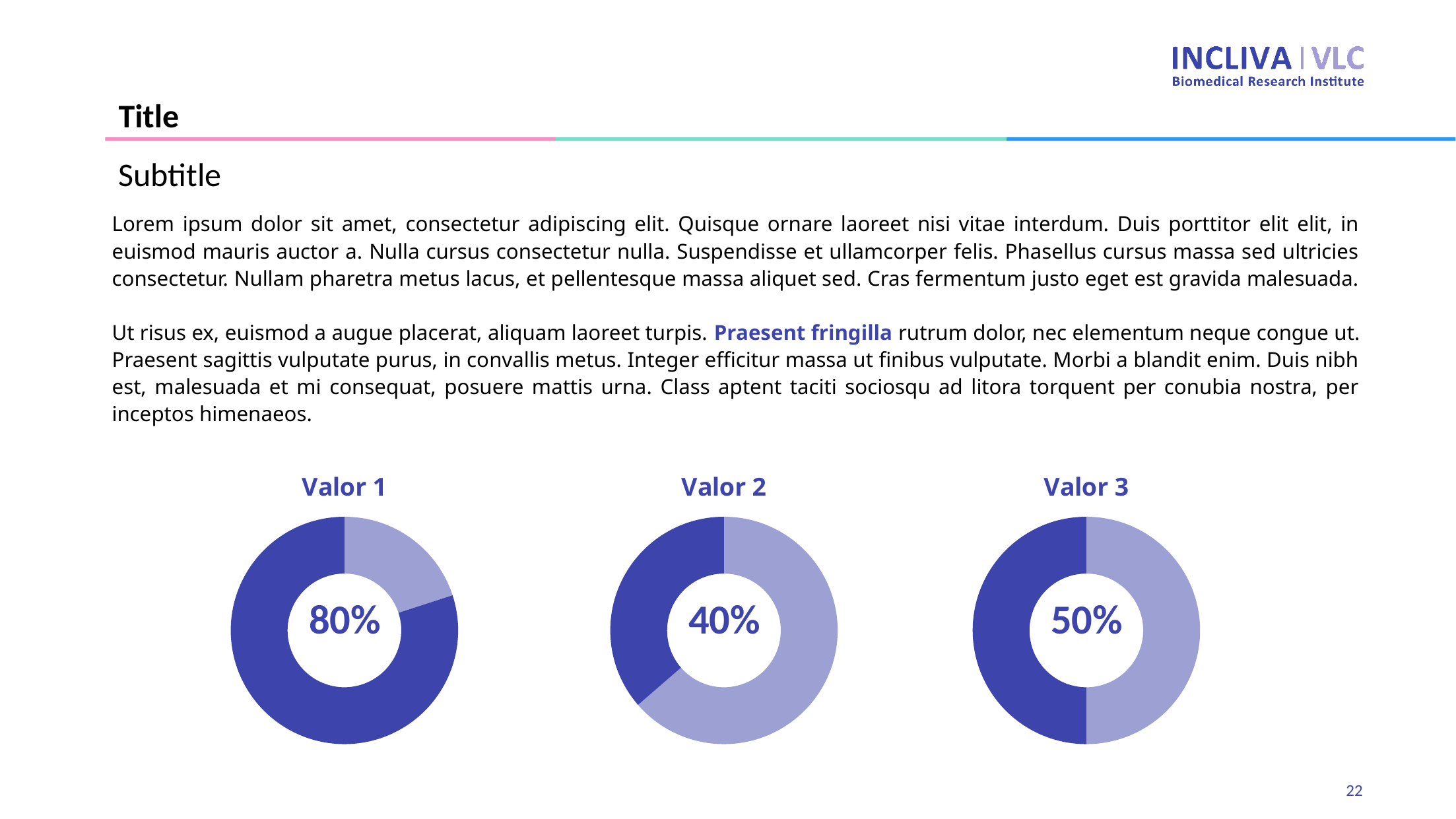
What is the difference between the percentage shown for Valor 3 and the percentage shown for Valor 2? 10% What is the title of the chart on the far right of the slide? Valor 3 Which of the three donut charts shows the highest percentage? Valor 1 Which is larger, the percentage for Valor 1 or the percentage for Valor 3? Valor 1 Which is larger, the percentage for Valor 2 or the percentage for Valor 3? Valor 3 Which of the three donut charts shows the lowest percentage? Valor 2 What kind of chart is used for Valor 1, Valor 2 and Valor 3? Donut chart How many donut charts are shown on the slide? 3 What value is shown in the centre of the Valor 1 donut chart? 80% What value is shown in the centre of the Valor 2 donut chart? 40% What value is shown in the centre of the Valor 3 donut chart? 50% What is the difference between the percentage shown for Valor 1 and the percentage shown for Valor 2? 40%